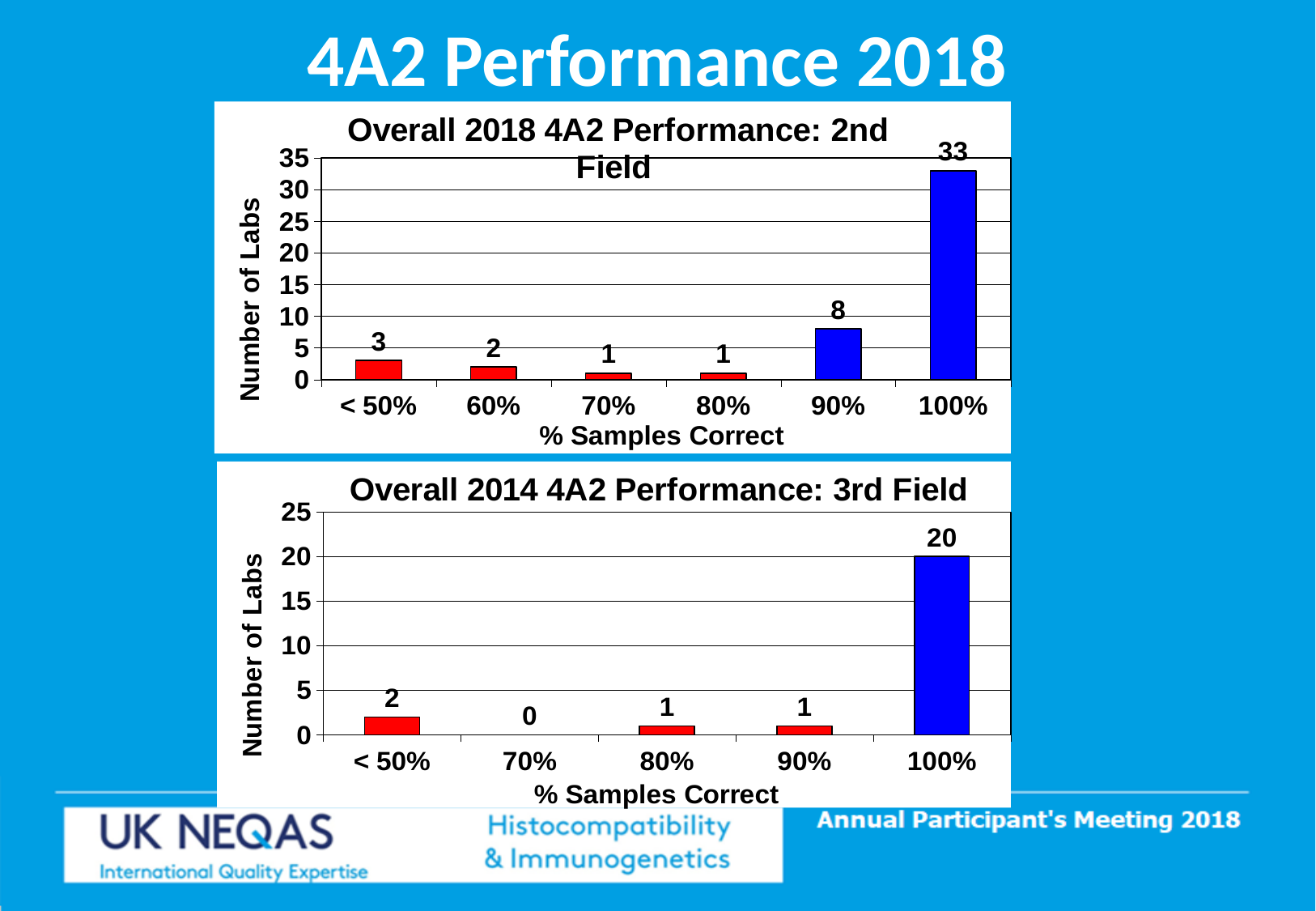
In the 'Overall 2018 4A2 Performance: 2nd Field' chart, is the value for < 50% larger or smaller than the value for 60%? larger What is the x-axis label of the 'Overall 2018 4A2 Performance: 2nd Field' chart? % Samples Correct In the 'Overall 2014 4A2 Performance: 3rd Field' chart, how many labs are in the 70% category? 0 In the 'Overall 2018 4A2 Performance: 2nd Field' chart, how many categories are shown on the x axis? 6 In the 'Overall 2014 4A2 Performance: 3rd Field' chart, which category has the lowest number of labs? 70% In the 'Overall 2018 4A2 Performance: 2nd Field' chart, what is the difference between the number of labs at 100% and at 90%? 25 In the 'Overall 2018 4A2 Performance: 2nd Field' chart, how many labs are in the 100% category? 33 In the 'Overall 2018 4A2 Performance: 2nd Field' chart, how many labs are in the 90% category? 8 In the 'Overall 2014 4A2 Performance: 3rd Field' chart, how many categories are shown on the x axis? 5 In the 'Overall 2014 4A2 Performance: 3rd Field' chart, how many labs are in the 100% category? 20 What type of chart is the 'Overall 2014 4A2 Performance: 3rd Field' chart? bar chart In the 'Overall 2018 4A2 Performance: 2nd Field' chart, which category has the highest number of labs? 100%